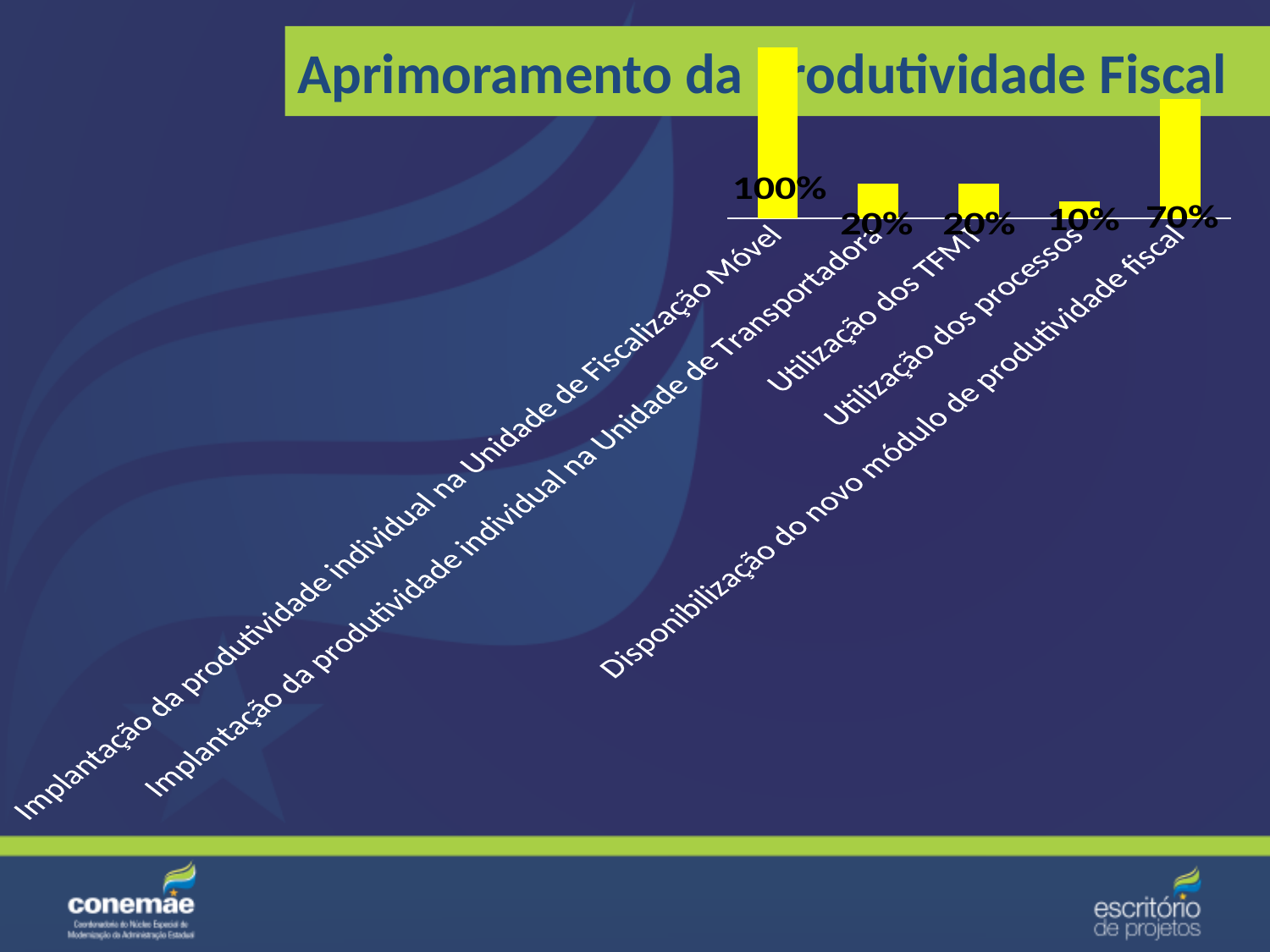
What colour are the bars in the chart? yellow Which category has the lowest value? Utilização dos processos What is the value for "Utilização dos processos"? 10% Which category has the highest value? Implantação da produtividade individual na Unidade de Fiscalização Móvel How many bars does the chart show? 5 What is the value for "Implantação da produtividade individual na Unidade de Transportadora"? 20% What kind of chart is shown on the slide? bar chart Which is larger, the value for "Utilização dos TFM" or the value for "Utilização dos processos"? Utilização dos TFM What is the difference between the values for "Implantação da produtividade individual na Unidade de Fiscalização Móvel" and "Disponibilização do novo módulo de produtividade fiscal"? 30% What is the value for "Disponibilização do novo módulo de produtividade fiscal"? 70% What is the value for "Implantação da produtividade individual na Unidade de Fiscalização Móvel"? 100% What is the value for "Utilização dos TFM"? 20%